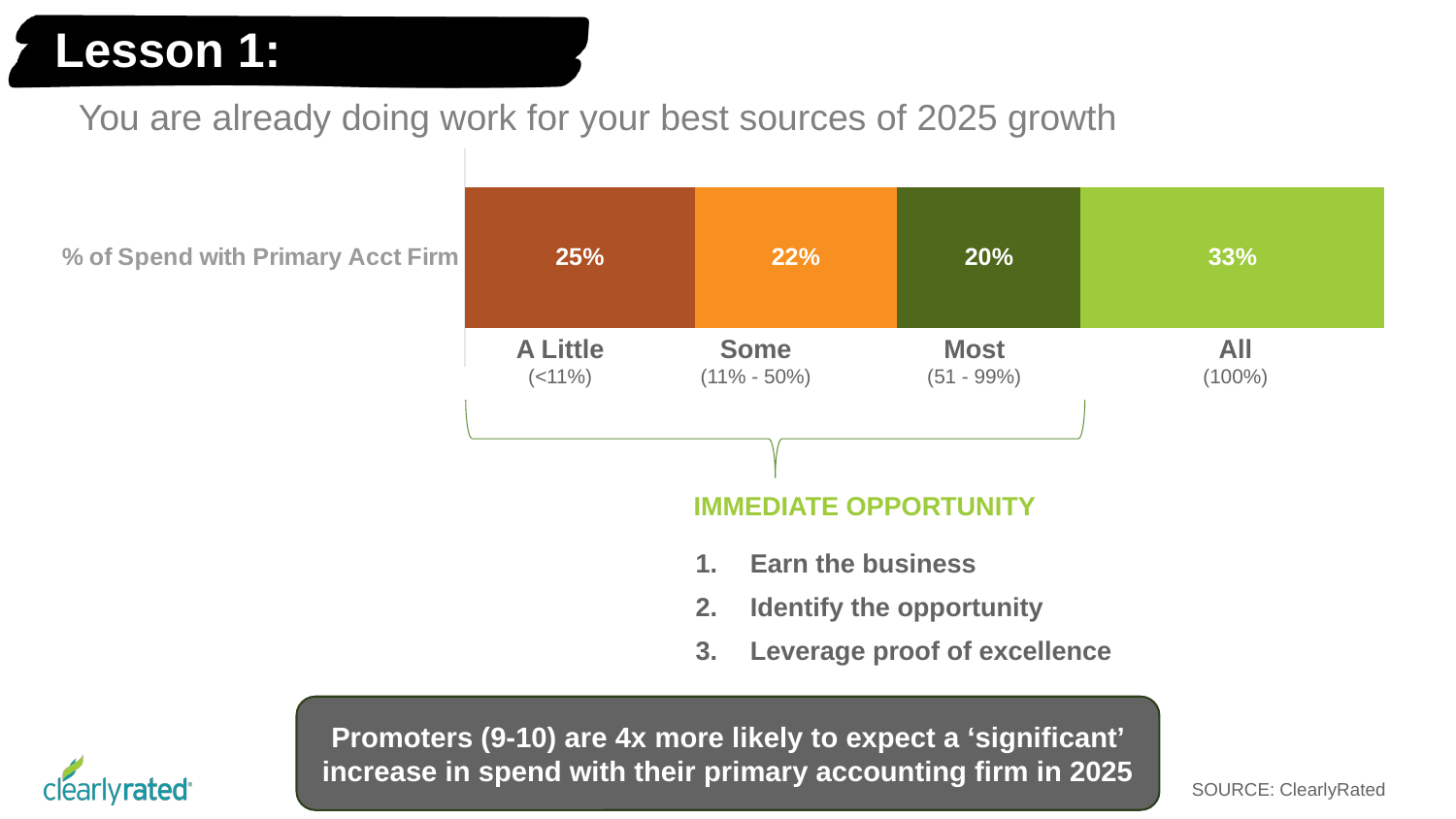
What percentage of respondents spend 'Some' (11% - 50%) with their primary accounting firm? 22% What is the difference between the 'A Little' share and the 'Some' share? 3% What is the difference between the 'All' share and the 'Most' share? 13% What kind of chart is used to show the % of spend with primary accounting firm? Stacked bar chart What percentage of respondents spend 'All' (100%) with their primary accounting firm? 33% What is the combined share of the three categories bracketed as 'Immediate Opportunity' (A Little, Some, Most)? 67% Which spend category has the largest share? All Which is larger, the share for 'A Little' or the share for 'Some'? A Little What percentage of respondents spend 'Most' (51 - 99%) with their primary accounting firm? 20% What percentage of respondents spend 'A Little' (<11%) with their primary accounting firm? 25% Which spend category has the smallest share? Most How many spend categories are shown in the bar? 4